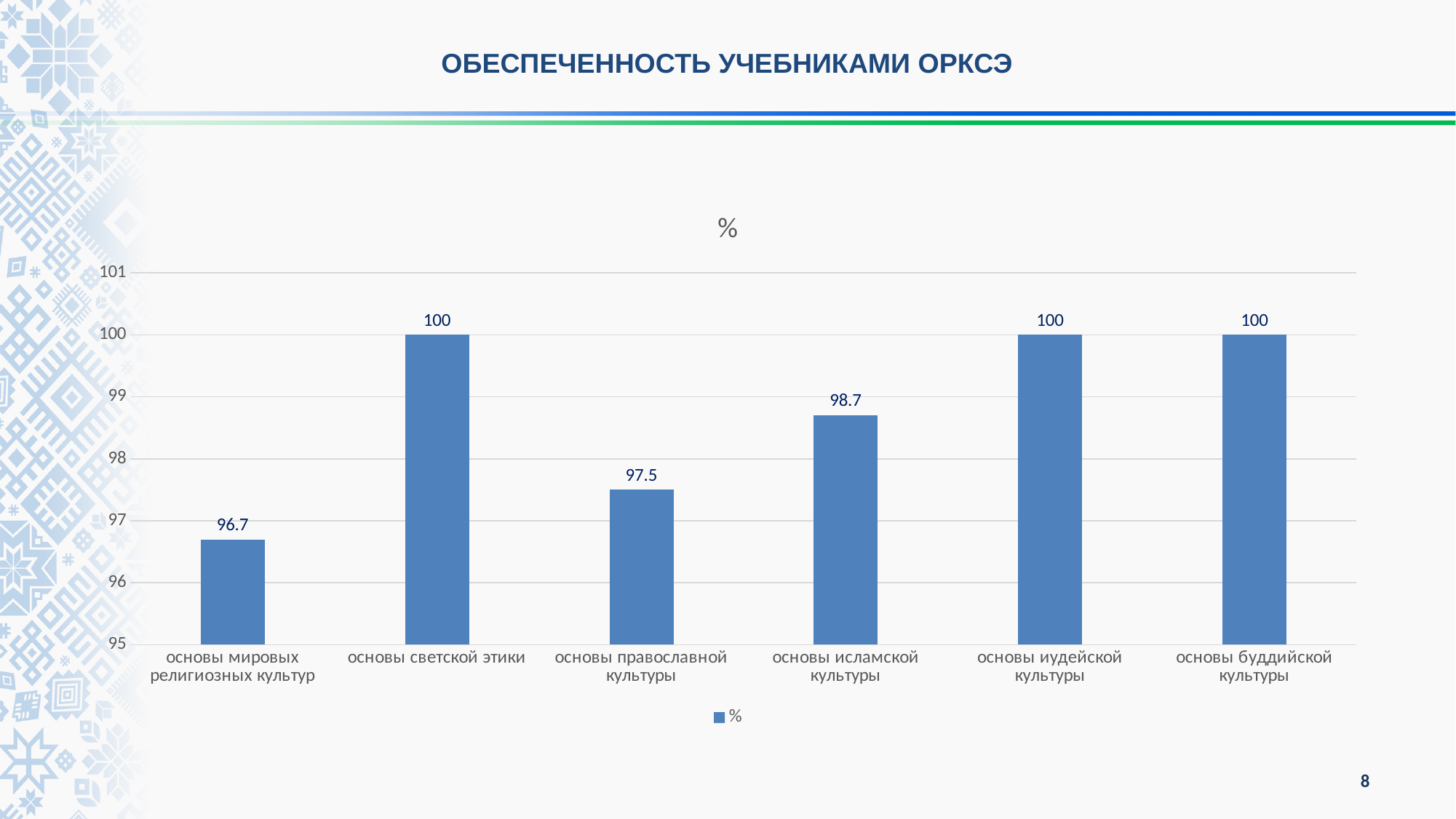
What is the value for основы православной культуры? 97.5 What is the difference between the values for основы исламской культуры and основы мировых религиозных культур? 2 What is the value for основы исламской культуры? 98.7 What kind of chart is shown on the slide? bar chart Which is larger: the value for основы православной культуры or основы исламской культуры? основы исламской культуры How many categories reach the maximum value of 100? 3 What is the title of the chart? % What is the difference between the values for основы светской этики and основы православной культуры? 2.5 What is the value for основы мировых религиозных культур? 96.7 How many categories are shown on the x axis? 6 Which category has the lowest value? основы мировых религиозных культур What is the value for основы светской этики? 100